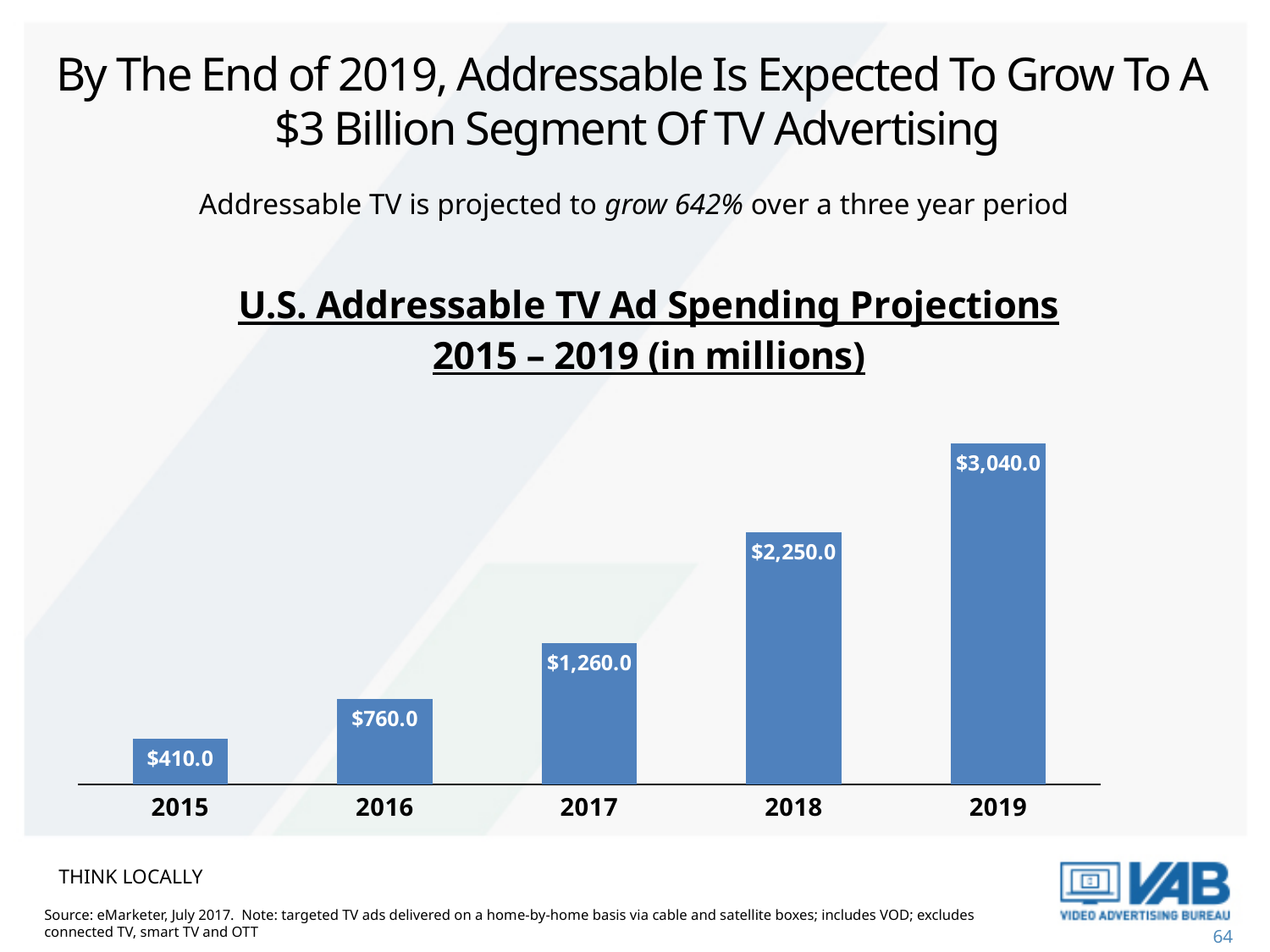
What is the title of the chart? U.S. Addressable TV Ad Spending Projections 2015 – 2019 (in millions) Which year has a larger projected spending, 2016 or 2017? 2017 Which year has the lowest projected addressable TV ad spending? 2015 How many years are shown on the chart? 5 What is the difference between the projected spending in 2019 and 2015? $2,630.0 What is the projected U.S. addressable TV ad spending for 2017? $1,260.0 Do the projected spending values rise or fall from 2015 to 2019? Rise What is the projected U.S. addressable TV ad spending for 2019? $3,040.0 What kind of chart is shown on the slide? Bar chart What is the projected U.S. addressable TV ad spending for 2015? $410.0 Which year has the highest projected addressable TV ad spending? 2019 What is the difference between the projected spending in 2018 and 2016? $1,490.0